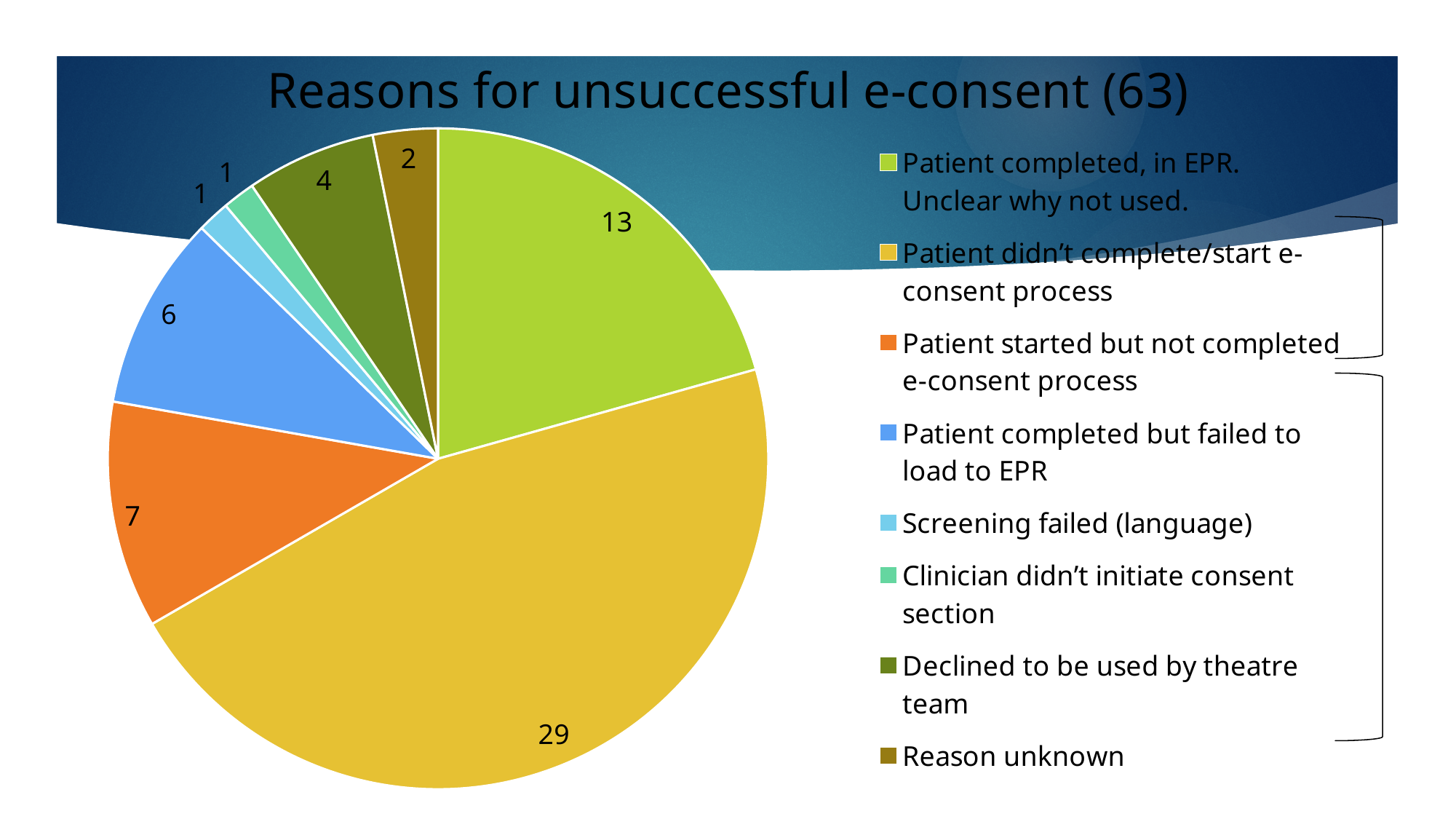
What is the title of the chart? Reasons for unsuccessful e-consent (63) What type of chart is shown on the slide? pie chart What is the value for 'Patient completed, in EPR. Unclear why not used.'? 13 Which category has the largest slice of the pie? Patient didn't complete/start e-consent process What is the value for 'Reason unknown'? 2 How many slices does the pie chart have? 8 What is the value for 'Declined to be used by theatre team'? 4 What is the value for 'Patient completed but failed to load to EPR'? 6 What is the value for 'Patient started but not completed e-consent process'? 7 Which is larger: the value for 'Patient started but not completed e-consent process' or 'Patient completed but failed to load to EPR'? Patient started but not completed e-consent process What is the difference between the values for 'Patient didn't complete/start e-consent process' and 'Patient completed, in EPR. Unclear why not used.'? 16 What is the value for 'Patient didn't complete/start e-consent process'? 29